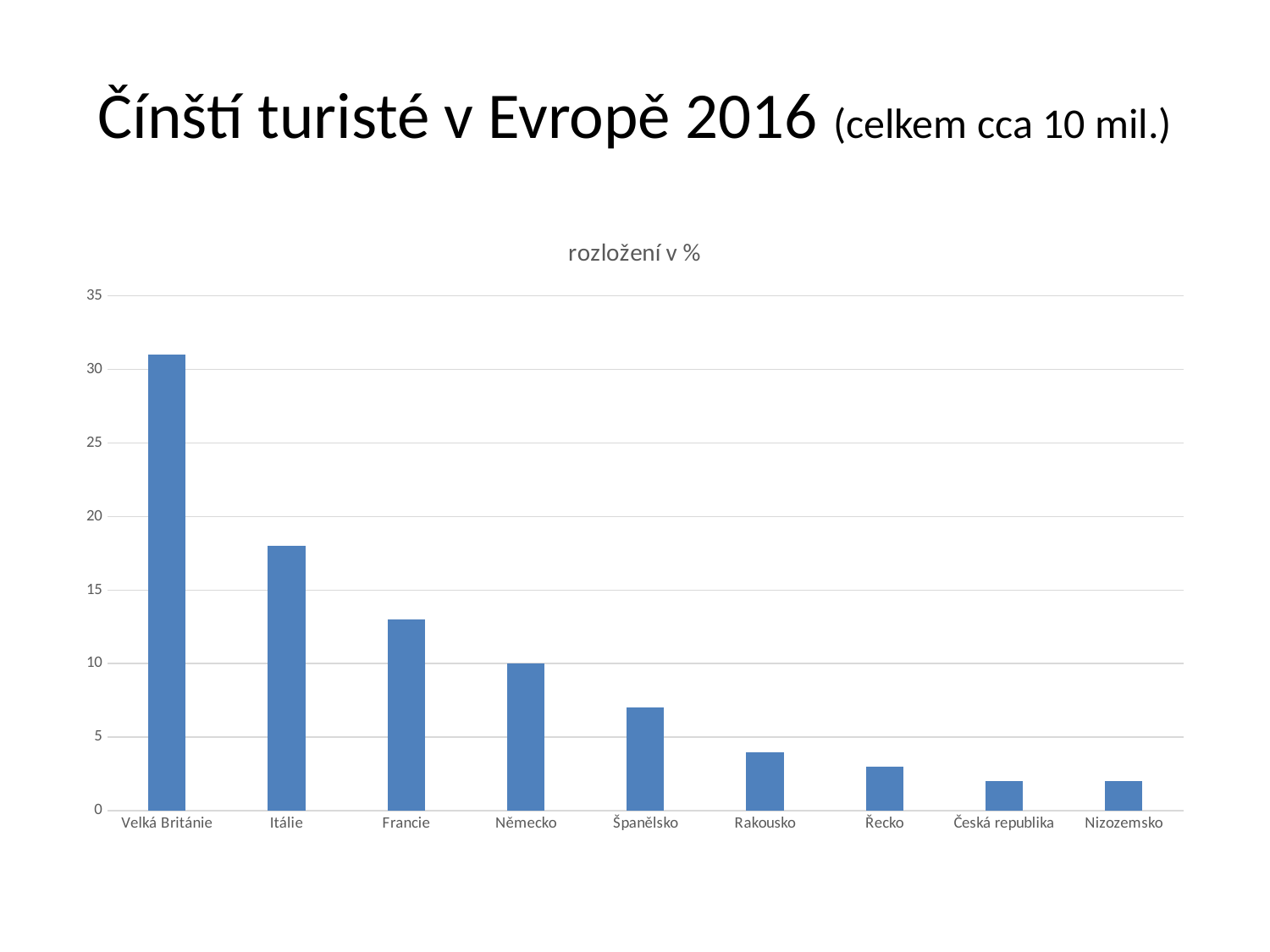
Which has a larger value, Itálie or Francie? Itálie Is the value for Španělsko greater or less than 5? greater What is the title shown above the chart? rozložení v % What is the value for Německo? 10 Is the value for Itálie greater or less than 20? less Is the value for Rakousko greater or less than 5? less Do the values rise or fall from left to right along the x axis? fall Which country has the highest value in the chart? Velká Británie How many countries are shown on the x axis of the chart? 9 What kind of chart is shown on the slide? bar chart